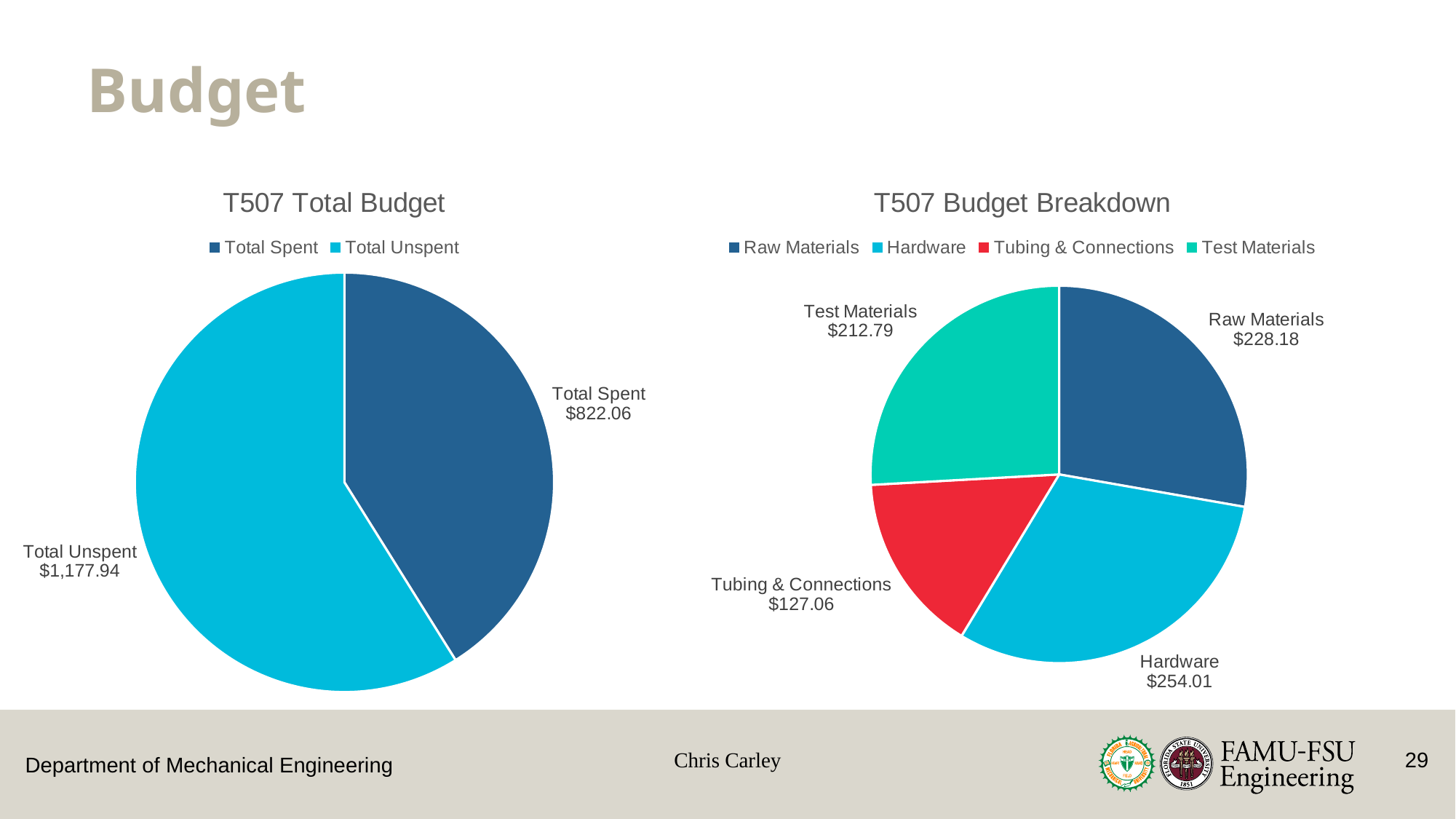
How many categories are shown in the T507 Budget Breakdown chart? 4 In the T507 Total Budget chart, what is the value for Total Spent? $822.06 In the T507 Total Budget chart, what is the difference between Total Unspent and Total Spent? $355.88 In the T507 Budget Breakdown chart, what is the value for Tubing & Connections? $127.06 In the T507 Budget Breakdown chart, which category has the lowest value? Tubing & Connections In the T507 Total Budget chart, what is the value for Total Unspent? $1,177.94 What type of chart is the T507 Total Budget chart? Pie chart In the T507 Budget Breakdown chart, which category has the highest value? Hardware In the T507 Total Budget chart, which slice is larger, Total Spent or Total Unspent? Total Unspent In the T507 Budget Breakdown chart, what is the difference between Raw Materials and Test Materials? $15.39 In the T507 Budget Breakdown chart, which colour represents Tubing & Connections? Red In the T507 Budget Breakdown chart, what is the value for Hardware? $254.01